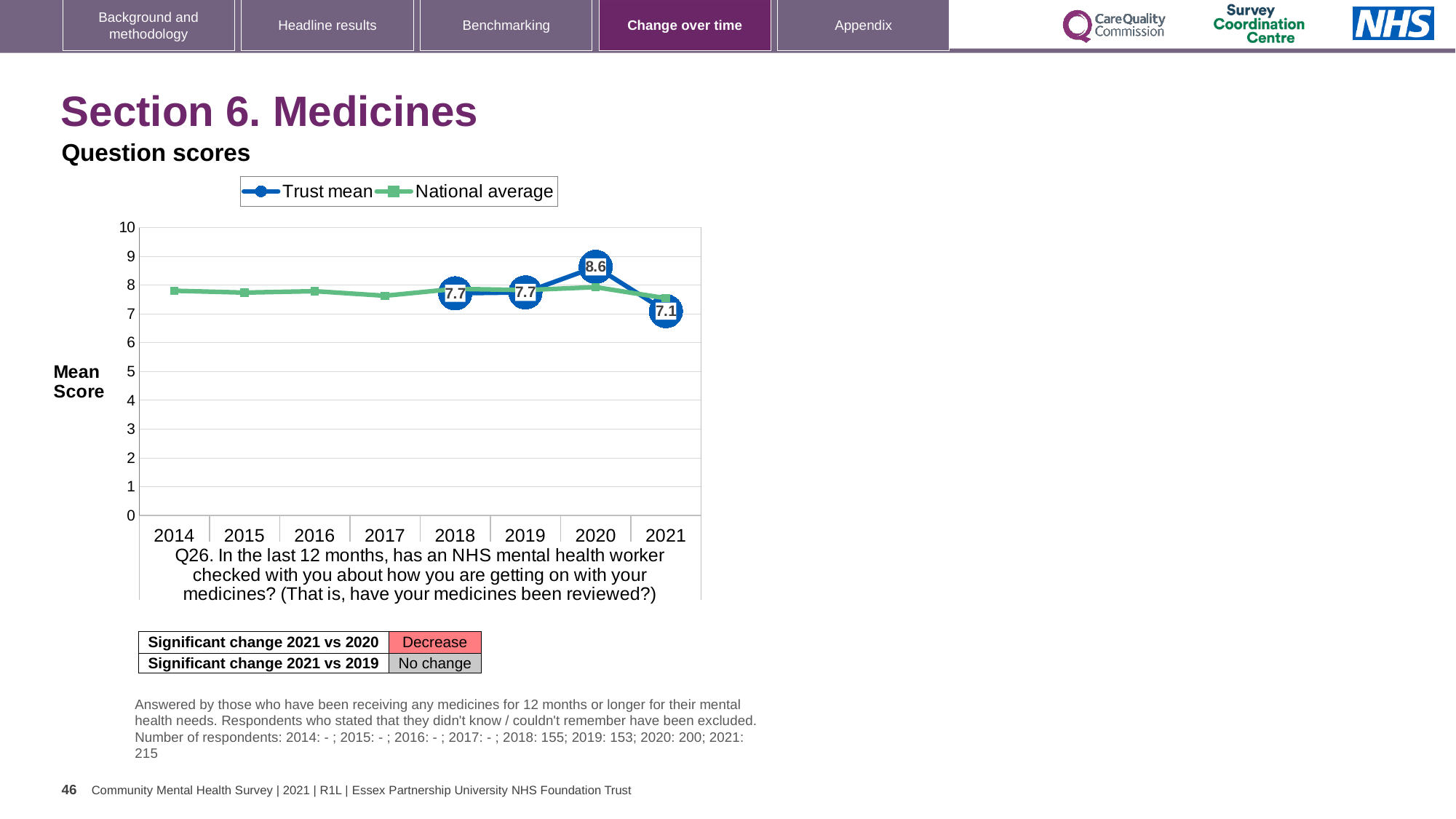
What is the Trust mean score for 2021? 7.1 What is the Trust mean score for 2020? 8.6 Which is larger, the Trust mean score in 2020 or in 2019? 2020 Is the National average value for 2014 greater or less than 7? greater Did the Trust mean score rise or fall from 2020 to 2021? Fall In which year is the Trust mean score lowest? 2021 What is the difference between the Trust mean score in 2020 and in 2021? 1.5 In which year is the Trust mean score highest? 2020 How many years are shown on the x axis of the chart? 8 What is the Trust mean score for 2018? 7.7 How many series does the chart legend list? 2 What kind of chart is shown on the slide? Line chart